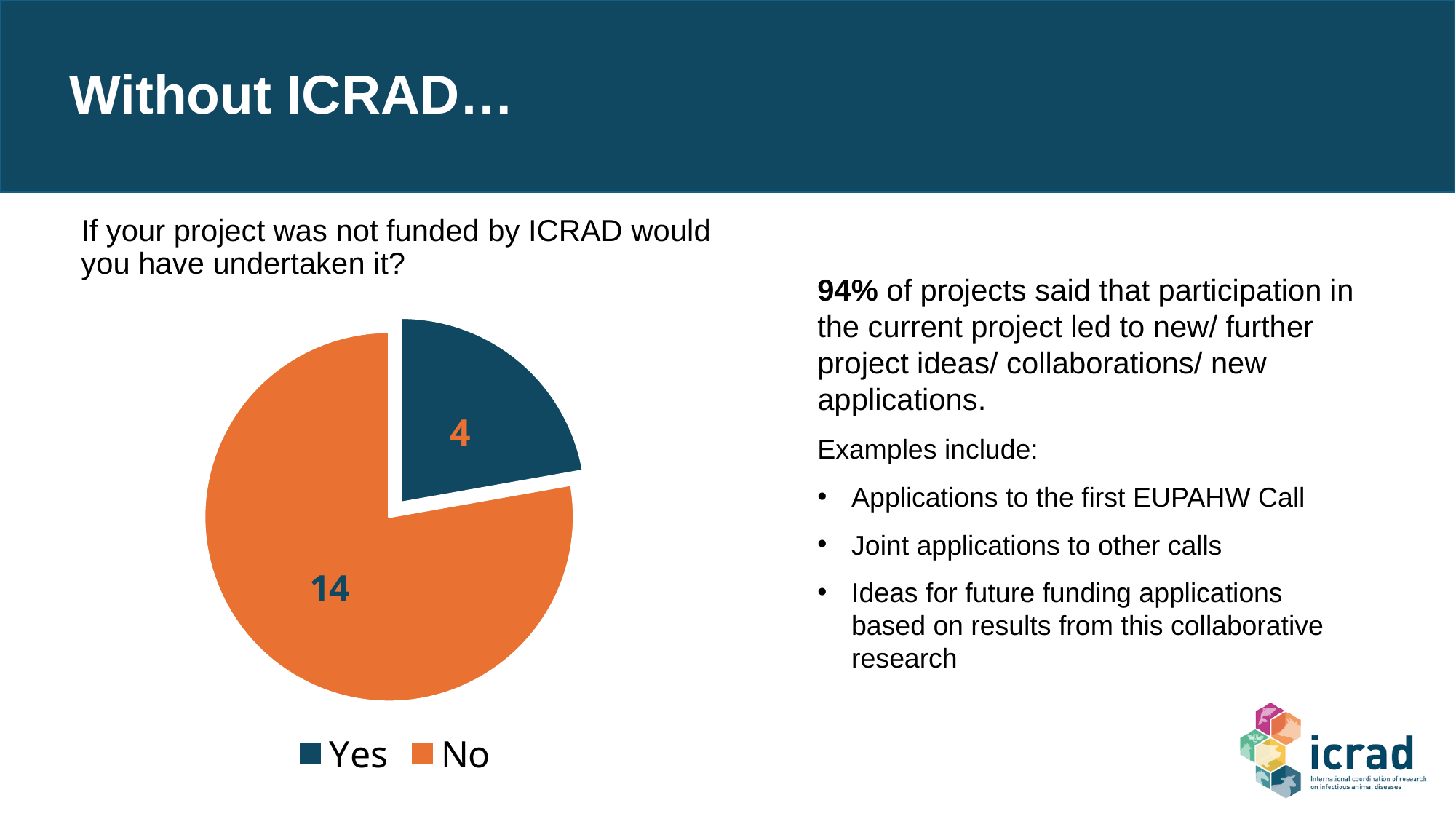
How many entries does the legend of the pie chart list? 2 Which colour represents the "No" responses in the pie chart? Orange What is the total number of responses shown in the pie chart? 18 Which category has the largest slice in the pie chart? No What kind of chart is shown on the slide? Pie chart How many projects answered "Yes" to whether they would have undertaken the project without ICRAD funding? 4 What is the difference between the number of "No" responses and the number of "Yes" responses? 10 Which category has the smallest slice in the pie chart? Yes Which response has the larger slice in the pie chart, Yes or No? No How many projects answered "No" in the pie chart? 14 How many categories does the pie chart have? 2 What share of the responses in the pie chart are "Yes"? 4 out of 18